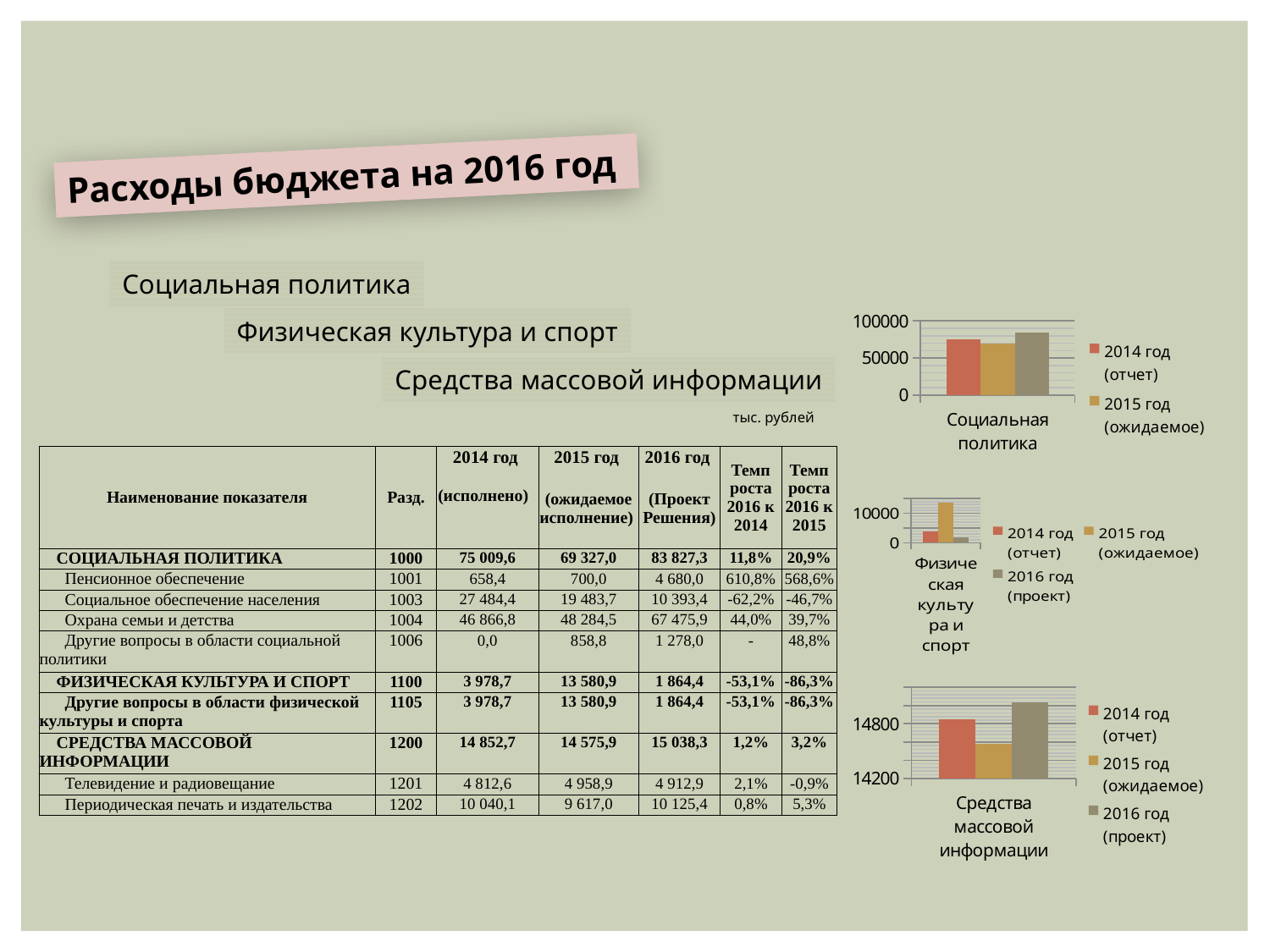
In the chart titled 'Средства массовой информации', which series has the tallest bar? 2016 год (проект) In the chart titled 'Физическая культура и спорт', which series has the lowest value? 2016 год (проект) What kind of chart is the chart titled 'Средства массовой информации'? bar chart In the chart titled 'Социальная политика', which is larger: the 2015 год (ожидаемое) bar or the 2016 год (проект) bar? 2016 год (проект) In the chart titled 'Средства массовой информации', is the value for 2015 год (ожидаемое) greater or less than 14800? less How many series does the legend of the chart titled 'Физическая культура и спорт' list? 3 In the chart titled 'Социальная политика', is the value for 2014 год (отчет) greater or less than 50000? greater In the chart titled 'Физическая культура и спорт', is the value for 2014 год (отчет) greater or less than 10000? less In the chart titled 'Социальная политика', which series has the tallest bar? 2016 год (проект) In the chart titled 'Физическая культура и спорт', which series has the highest value? 2015 год (ожидаемое)